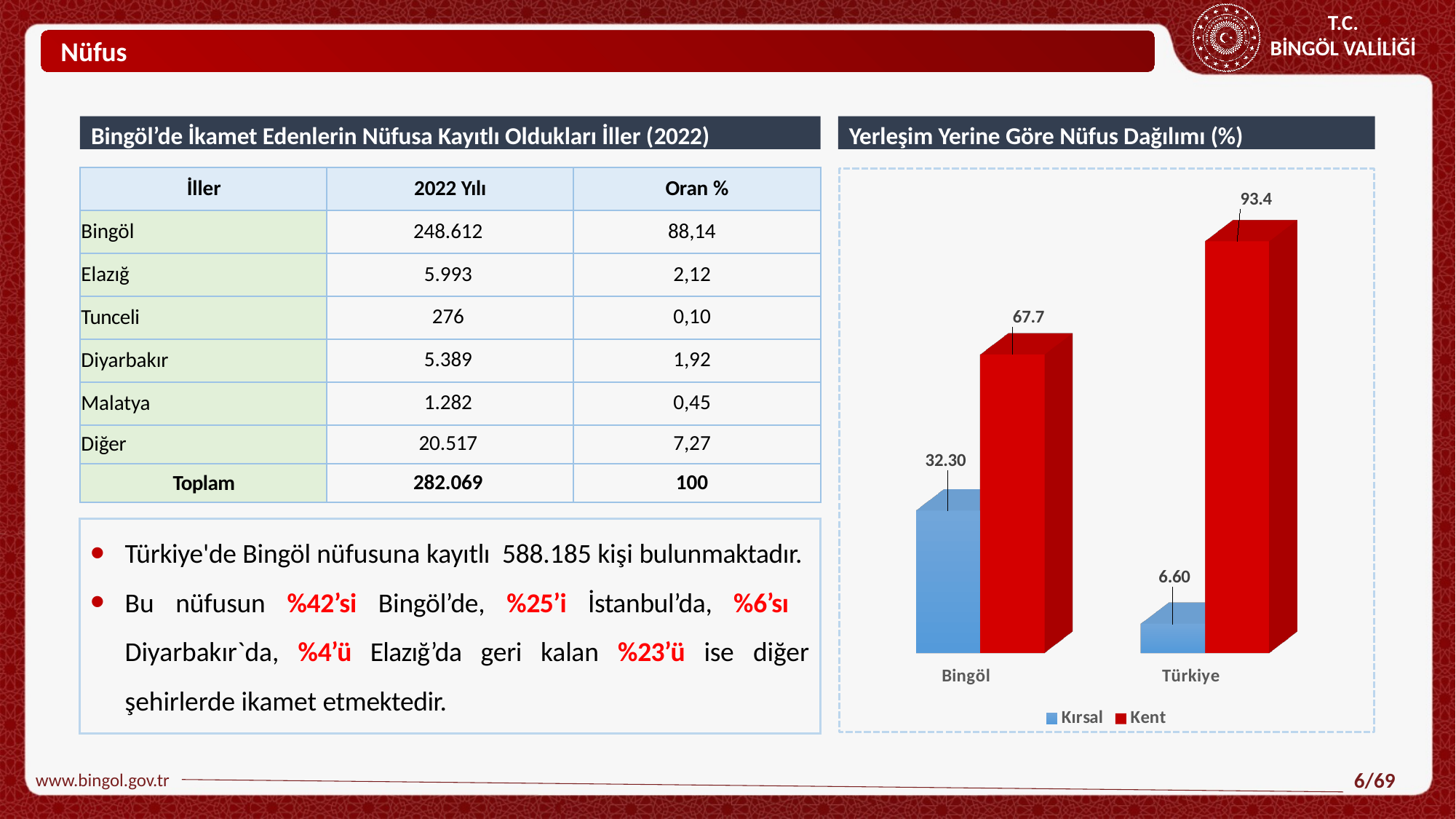
How many categories are shown on the x axis of the chart? 2 What is the Kent value for Türkiye in the chart? 93.4 Is the Kırsal value for Bingöl larger or smaller than the Kırsal value for Türkiye? larger Which category has the lowest Kırsal value in the chart? Türkiye How many series does the chart legend list? 2 What is the difference between the Kent values for Türkiye and Bingöl? 25.7 What type of chart is shown on the slide? bar chart What is the Kent value for Bingöl in the chart? 67.7 Which category has the highest Kent value in the chart? Türkiye What is the difference between the Kent and Kırsal values for Bingöl? 35.4 What is the Kırsal value for Türkiye in the chart? 6.60 What is the Kırsal value for Bingöl in the chart? 32.30